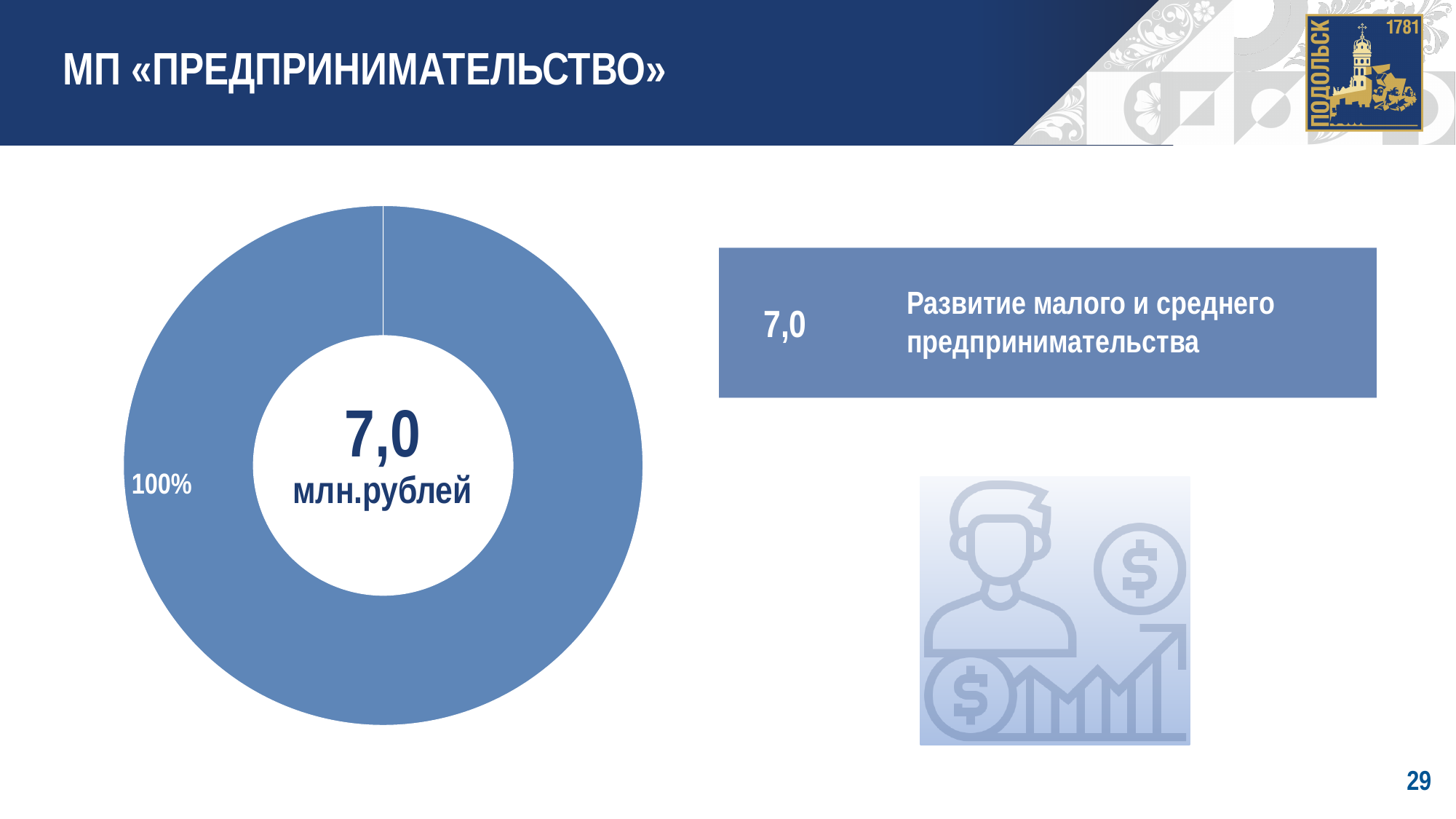
What value is shown for «Развитие малого и среднего предпринимательства»? 7,0 What unit is given for the value in the centre of the donut chart? млн.рублей What share of the donut chart does the single slice represent? 100% Which category makes up the whole donut chart? Развитие малого и среднего предпринимательства What kind of chart is shown on the slide? pie chart (donut) How many slices does the donut chart have? 1 What total value is printed in the centre of the donut chart? 7,0 млн.рублей What is the title of the slide containing the donut chart? МП «ПРЕДПРИНИМАТЕЛЬСТВО»